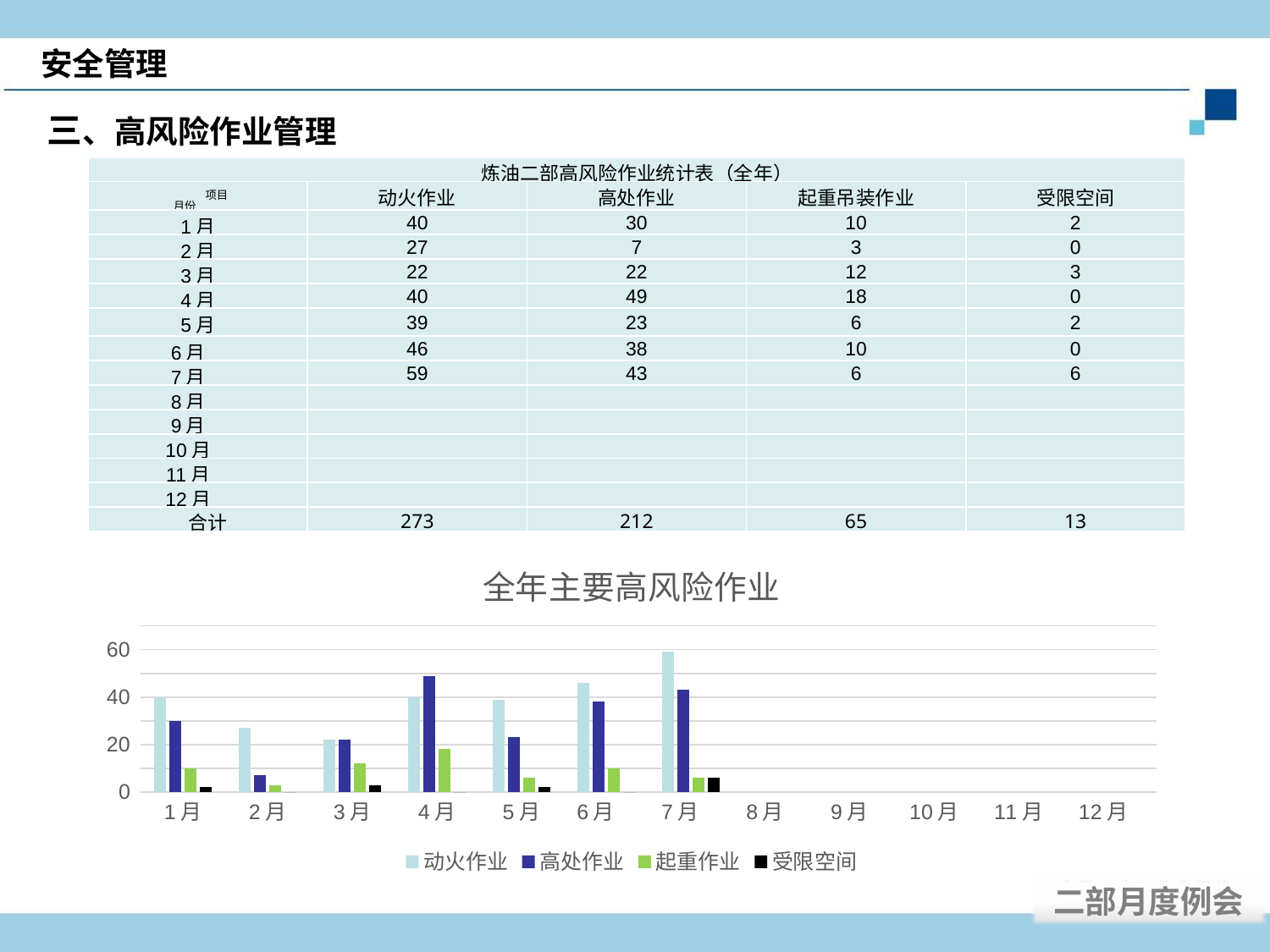
What kind of chart is shown on the slide? bar chart Is the 动火作业 value for 2月 greater or less than 20? greater How many month categories are shown on the x axis of the chart? 12 Among the months with data plotted, which month has the lowest 高处作业 value? 2月 What is the difference between the 动火作业 and 高处作业 values in 7月? 16 What is the 起重作业 value for 4月? 18 What is the title of the chart? 全年主要高风险作业 In 1月, which is larger: 动火作业 or 高处作业? 动火作业 Is the 高处作业 value for 4月 greater or less than 40? greater What is the 动火作业 value for 7月? 59 How many series does the chart legend list? 4 In which month is the 动火作业 value highest? 7月